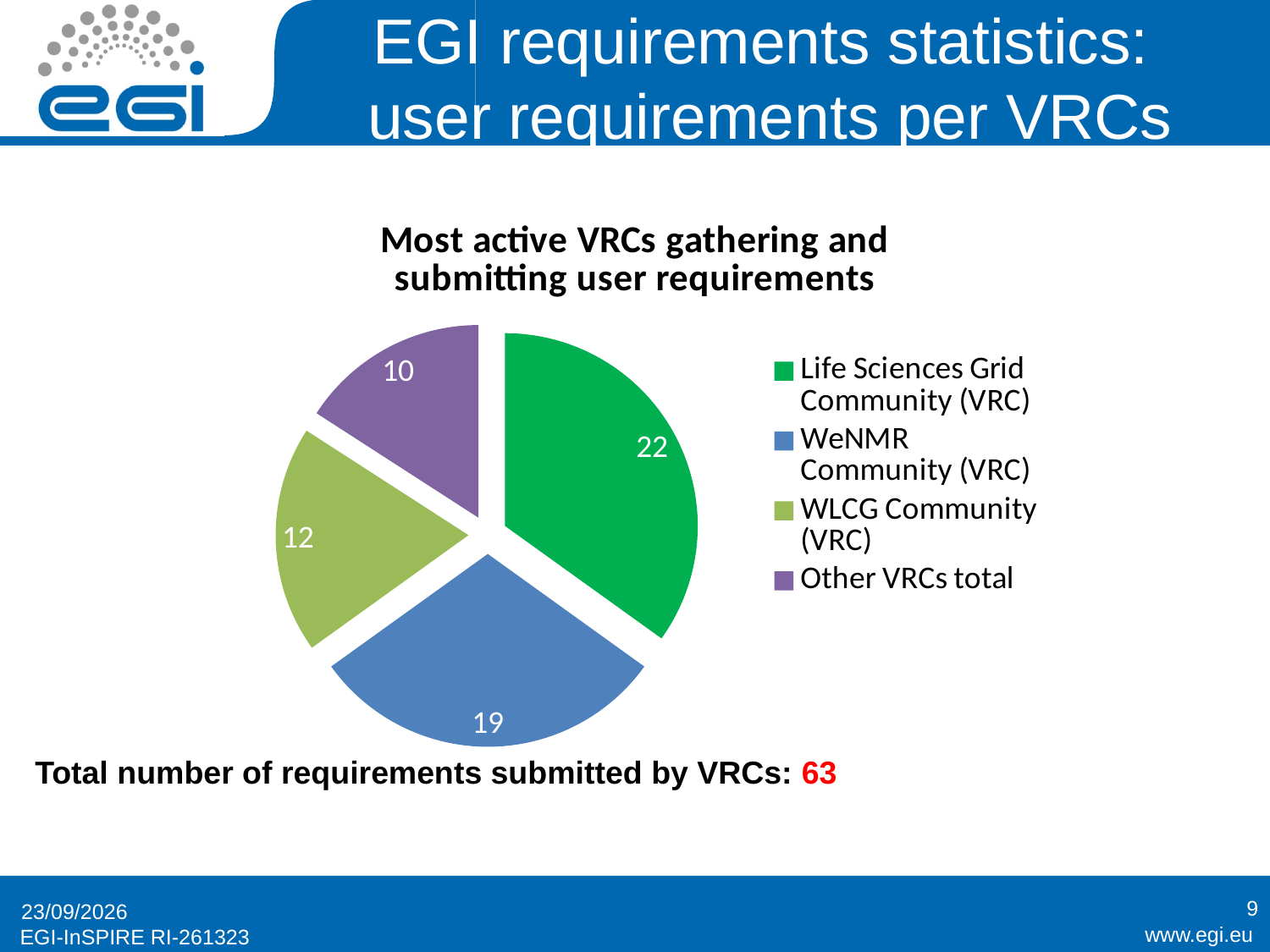
How many requirements were submitted by the WeNMR Community (VRC)? 19 How many requirements were submitted by the Life Sciences Grid Community (VRC)? 22 Which is larger, the WLCG Community (VRC) slice or the Other VRCs total slice? WLCG Community (VRC) How many requirements were submitted by the WLCG Community (VRC)? 12 How many slices does the pie chart have? 4 What type of chart is shown on the slide? pie chart What is the difference between the Life Sciences Grid Community (VRC) and WeNMR Community (VRC) values? 3 What value is shown for Other VRCs total? 10 Which VRC has the largest slice of the pie? Life Sciences Grid Community (VRC) What is the title of the chart? Most active VRCs gathering and submitting user requirements What is the total of all the slices in the pie chart? 63 Which category has the smallest slice of the pie? Other VRCs total